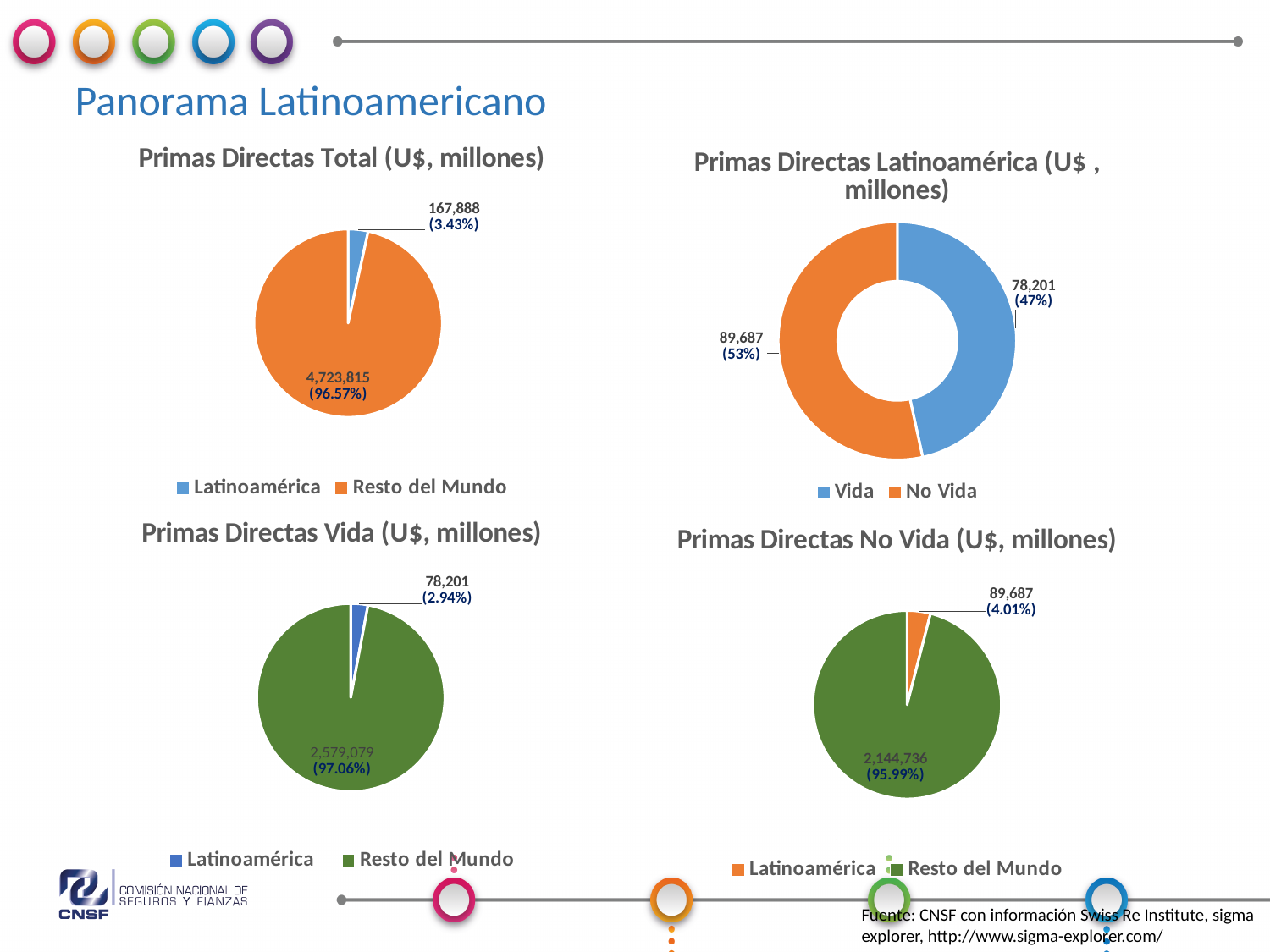
In the 'Primas Directas Latinoamérica (U$ , millones)' chart, which category is larger, Vida or No Vida? No Vida In the 'Primas Directas Latinoamérica (U$ , millones)' chart, what is the value for No Vida? 89,687 In the 'Primas Directas Vida (U$, millones)' chart, what share does Latinoamérica represent? 2.94% What type of chart is the 'Primas Directas Total (U$, millones)' chart? Pie chart In the 'Primas Directas Total (U$, millones)' chart, what is the value for Latinoamérica? 167,888 In the 'Primas Directas Total (U$, millones)' chart, what share of the pie does Resto del Mundo represent? 96.57% In the 'Primas Directas Latinoamérica (U$ , millones)' chart, what is the difference between No Vida and Vida? 11,486 In the 'Primas Directas No Vida (U$, millones)' chart, which category is the smallest? Latinoamérica In the 'Primas Directas Vida (U$, millones)' chart, what is the value for Resto del Mundo? 2,579,079 In the 'Primas Directas No Vida (U$, millones)' chart, what is the value for Resto del Mundo? 2,144,736 In the 'Primas Directas Total (U$, millones)' chart, what is the value for Resto del Mundo? 4,723,815 In the 'Primas Directas Latinoamérica (U$ , millones)' chart, what share does Vida represent? 47%